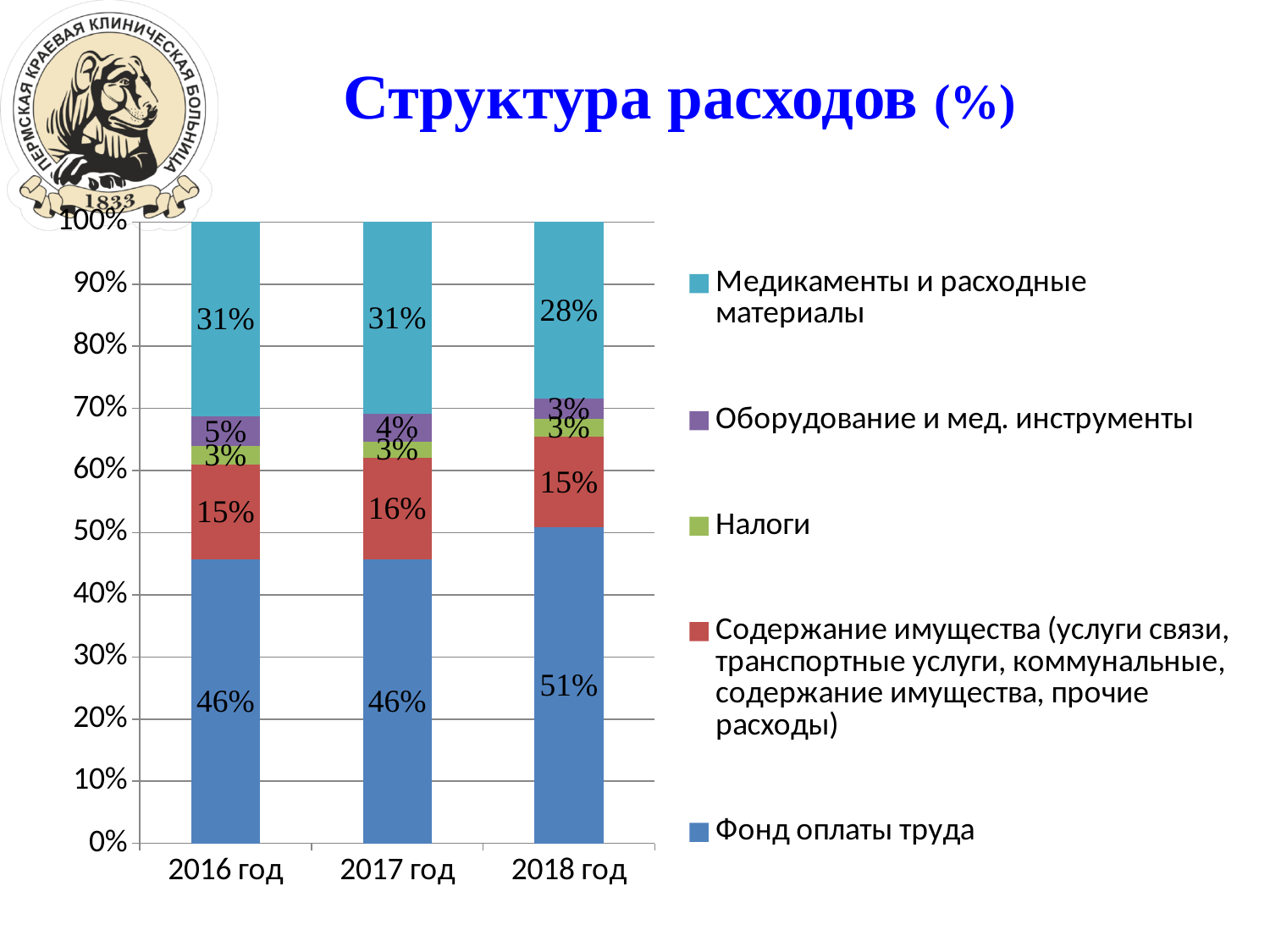
What share of expenses was Медикаменты и расходные материалы in 2016 год? 31% How many years are shown on the x axis of the chart? 3 Which was larger in 2016 год: the share of Оборудование и мед. инструменты or the share of Налоги? Оборудование и мед. инструменты What share of expenses was Содержание имущества in 2017 год? 16% How many series does the legend list? 5 In which year was the share of Фонд оплаты труда the highest? 2018 год What share of expenses was Налоги in 2018 год? 3% What kind of chart is shown on the slide? Stacked bar chart What share of expenses was Фонд оплаты труда in 2018 год? 51% What share of expenses was Оборудование и мед. инструменты in 2017 год? 4% By how many percentage points did the share of Фонд оплаты труда in 2018 год exceed that in 2017 год? 5% In which year was the share of Медикаменты и расходные материалы the lowest? 2018 год